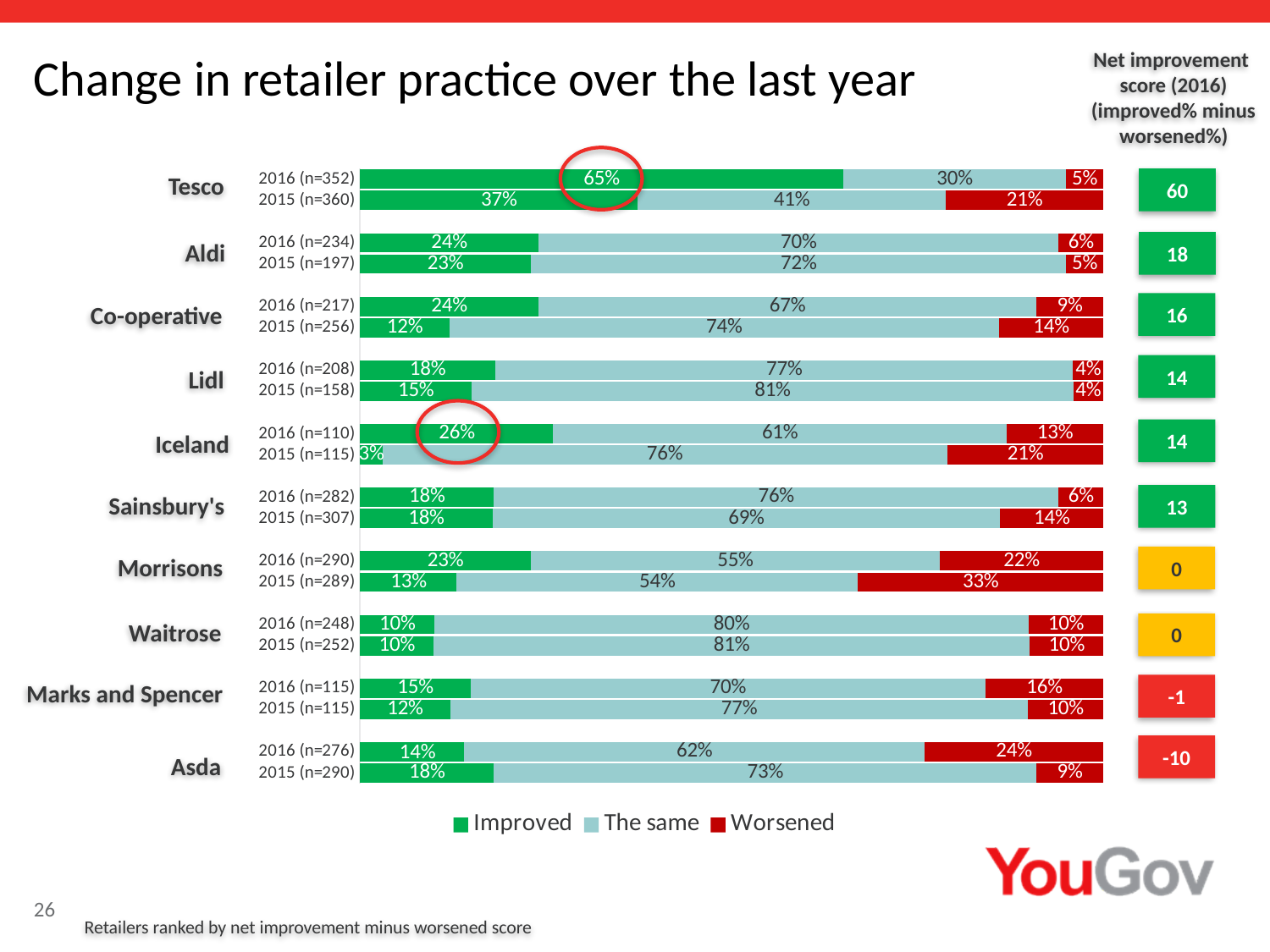
What is the net improvement score (2016) shown for Tesco? 60 Which is larger: the 2016 'Worsened' share for Asda or for Morrisons? Asda How many retailers are shown in the chart? 10 How many series does the legend list? 3 What percentage of respondents said Tesco's practice improved in 2016 (n=352)? 65% Which retailer has the highest 'Improved' percentage in 2016? Tesco What is the total of the three segments for Iceland's 2016 bar? 100% What is the 'The same' value for Lidl in 2016 (n=208)? 77% What percentage said Morrisons' practice worsened in 2015 (n=289)? 33% Which retailer has the lowest 'Improved' percentage in 2015? Iceland By how many percentage points did Tesco's 'Improved' share rise from 2015 to 2016? 28 percentage points What kind of chart is shown on the slide? Stacked bar chart